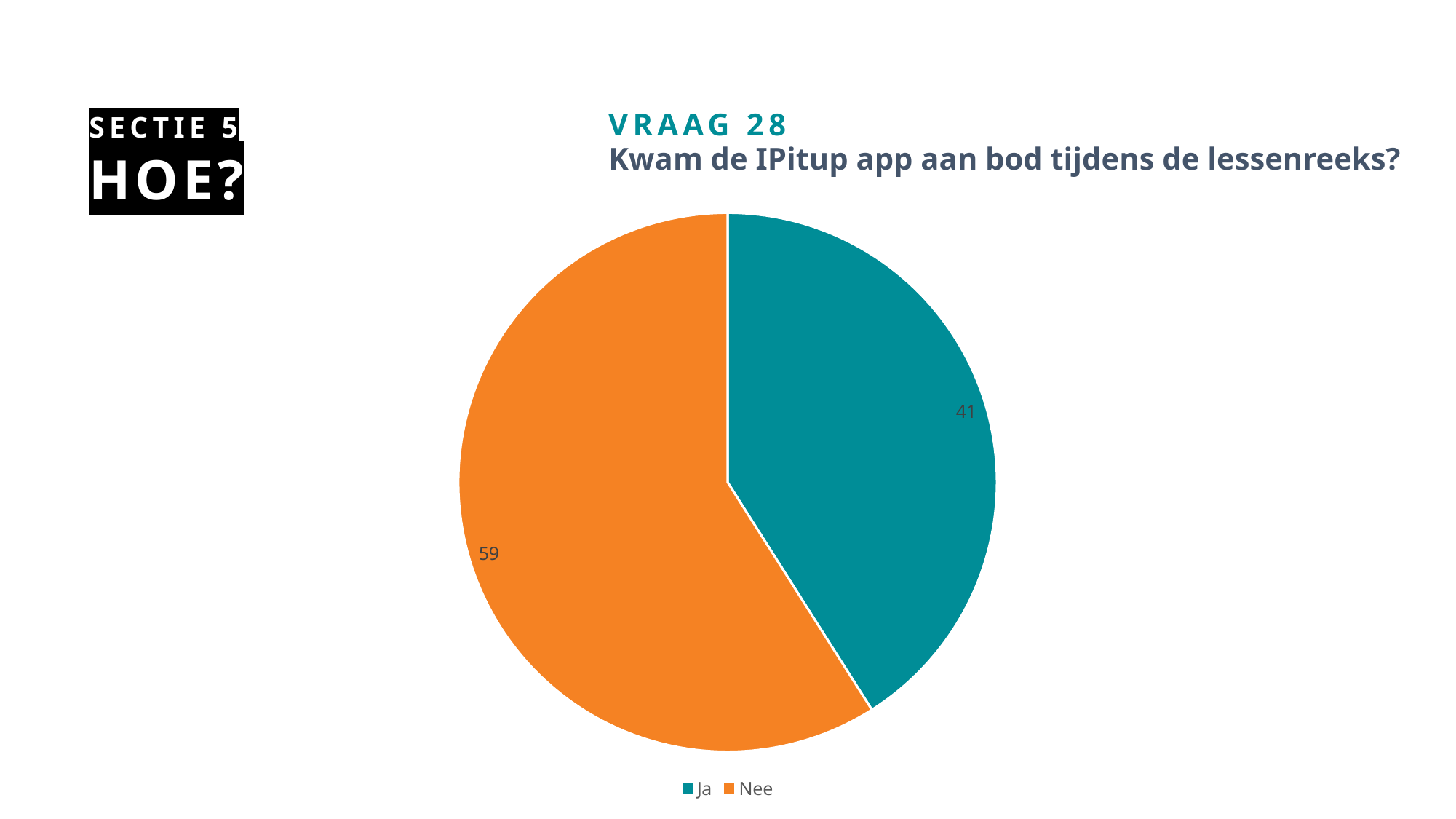
How many entries does the legend list? 2 What kind of chart is shown on the slide? pie chart What is the value for Ja? 41 What is the difference between the values for Nee and Ja? 18 How many slices does the pie chart have? 2 What share of the pie does Nee represent? 59% Which colour represents Ja in the pie chart? teal Which is larger, Ja or Nee? Nee Which category has the largest slice? Nee Which category has the smallest slice? Ja What is the value for Nee? 59 What is the total of the two slice values? 100